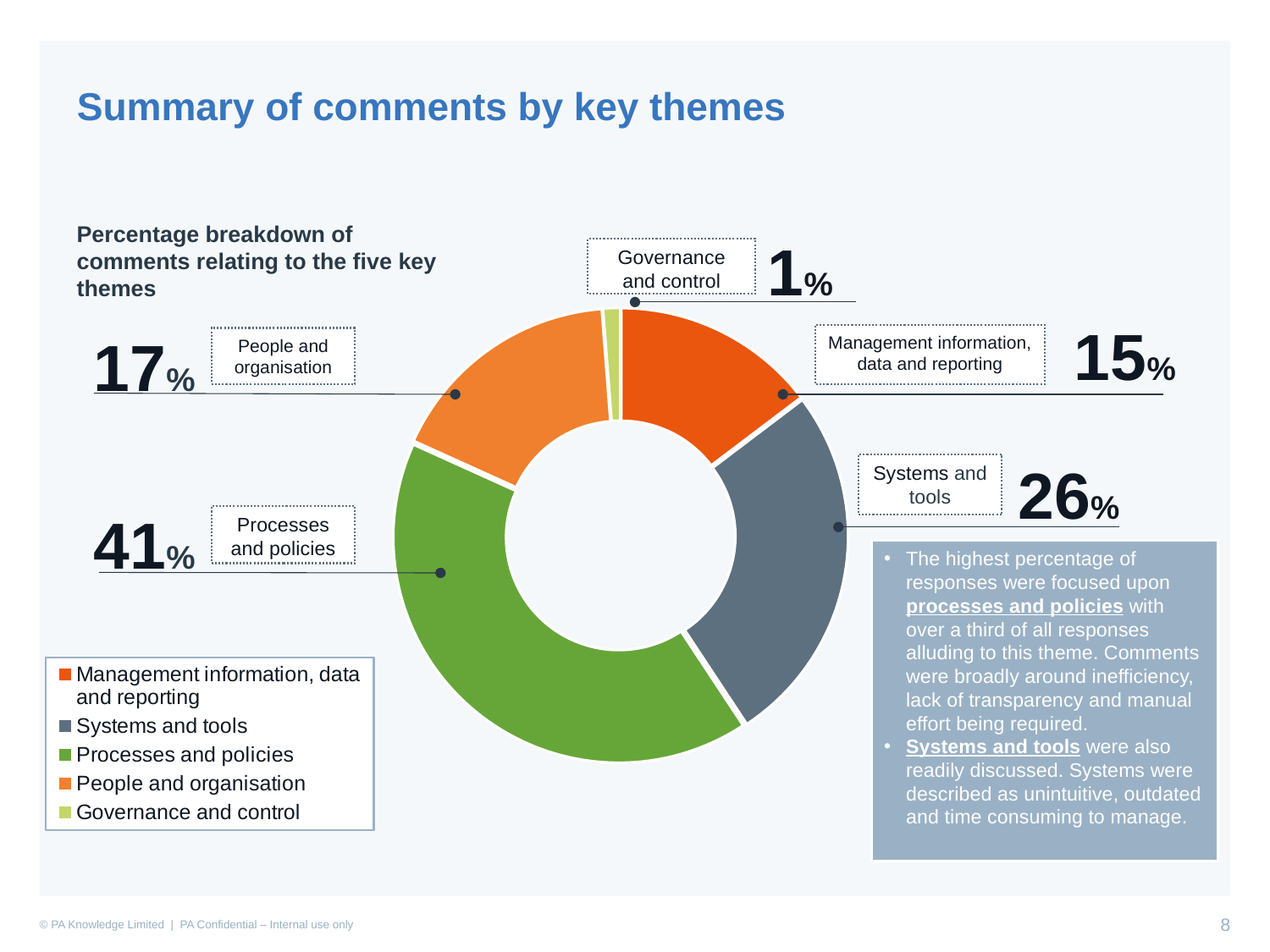
What percentage of comments relate to Governance and control? 1% What is the difference in percentage points between Processes and policies and Systems and tools? 15 Which theme has the highest percentage of comments? Processes and policies What is the title of the chart? Percentage breakdown of comments relating to the five key themes How many themes are shown in the chart? 5 What is the combined percentage for People and organisation and Management information, data and reporting? 32% What percentage of comments relate to Processes and policies? 41% What percentage of comments relate to Systems and tools? 26% Which theme has the lowest percentage of comments? Governance and control Which colour represents Systems and tools in the chart? Grey Which has a larger share of comments, People and organisation or Management information, data and reporting? People and organisation What kind of chart is shown on the slide? Doughnut (pie) chart